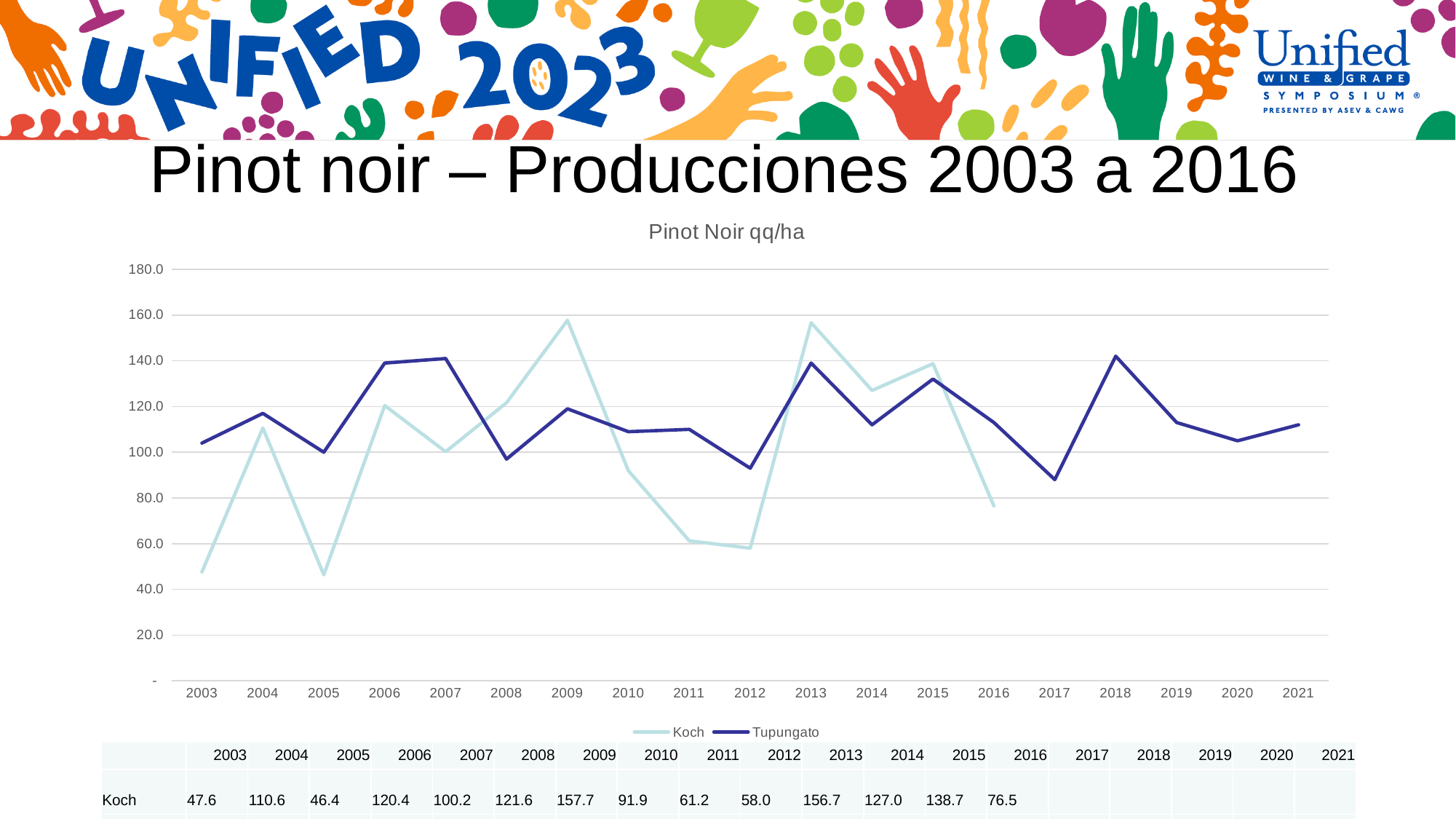
In which year is the Koch series at its lowest? 2005 How many years are shown on the x axis of the chart? 19 How many series does the chart legend list? 2 Is the Tupungato value for 2017 greater or less than 100? less Does the Koch series rise or fall from 2009 to 2012? fall What is the Koch value for 2009? 157.7 What is the Koch value for 2012? 58.0 What is the difference between the Koch values for 2009 and 2003? 110.1 Which is larger, the Koch value for 2004 or for 2005? 2004 What kind of chart is shown on the slide? line chart Is the Tupungato value for 2006 greater or less than 120? greater In which year is the Koch series at its highest? 2009